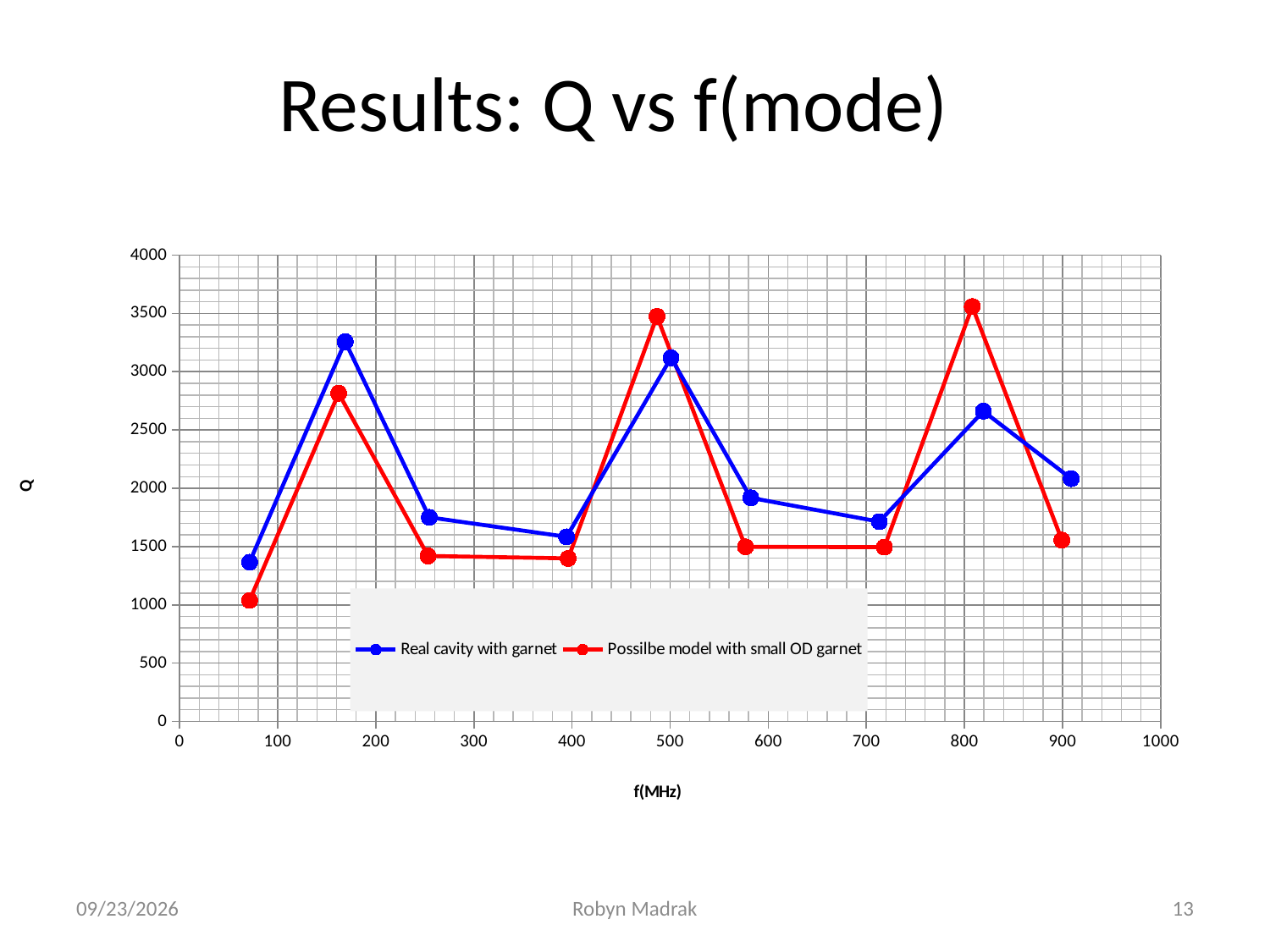
How many data points are plotted for the 'Possilbe model with small OD garnet' series? 9 How many series does the legend list? 2 Is the Q value of the 'Possilbe model with small OD garnet' series at its peak near 800 MHz greater or less than 3000? greater At the peak near 170 MHz, which series has the higher Q: 'Real cavity with garnet' or 'Possilbe model with small OD garnet'? Real cavity with garnet Is the Q value of the 'Possilbe model with small OD garnet' series at its first point near 70 MHz greater or less than 1500? less Is the Q value of the 'Real cavity with garnet' series at its peak near 170 MHz greater or less than 3000? greater At the peak near 500 MHz, which series has the higher Q: 'Real cavity with garnet' or 'Possilbe model with small OD garnet'? Possilbe model with small OD garnet What is the label of the x axis? f(MHz) What kind of chart is shown on the slide? line chart How many data points are plotted for the 'Real cavity with garnet' series? 9